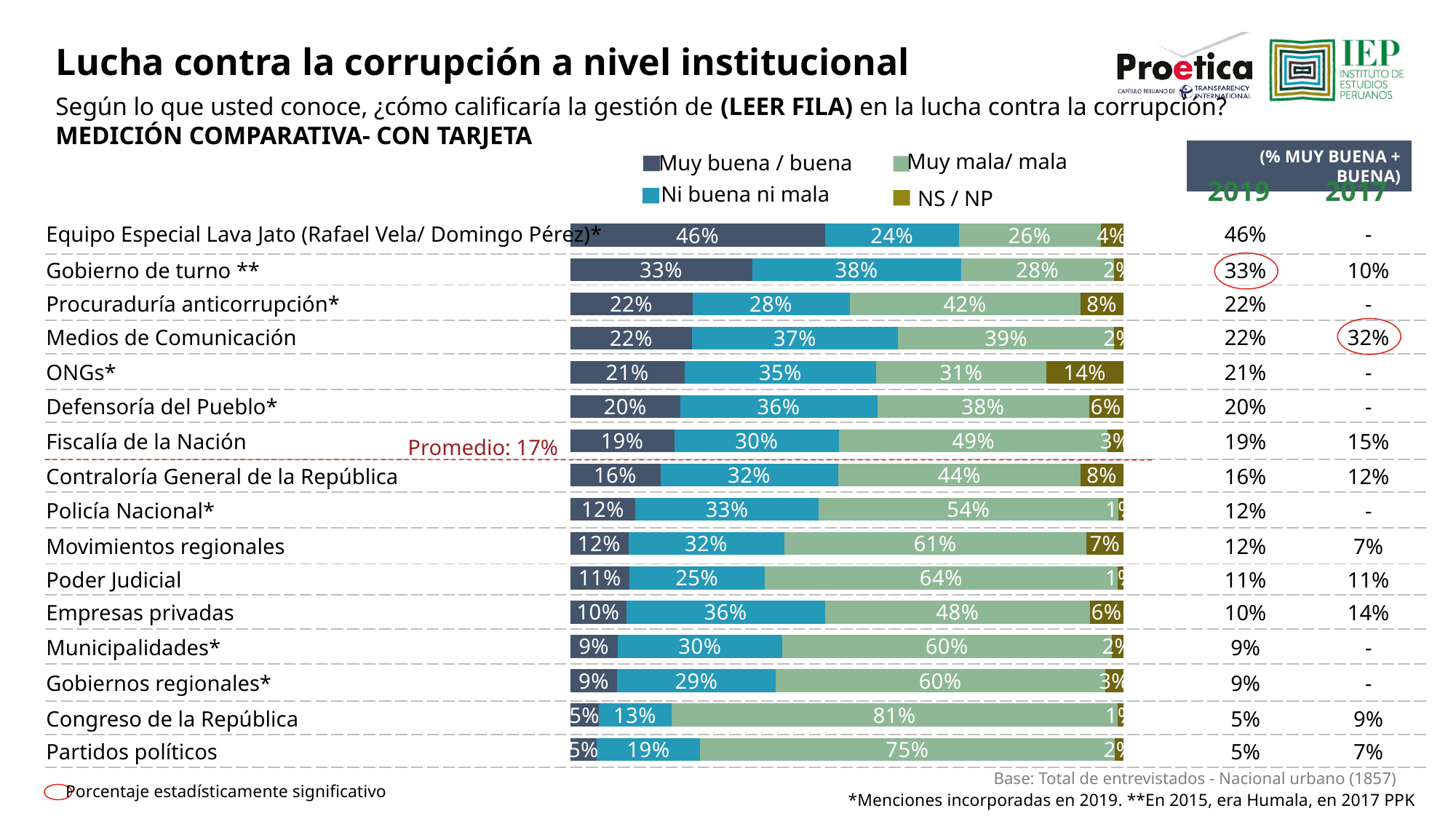
What is the difference between the 'Muy mala/ mala' values for Poder Judicial and Partidos políticos? 11% Which institution has the highest 'Muy buena / buena' value? Equipo Especial Lava Jato (Rafael Vela/ Domingo Pérez) What is the 'NS / NP' value for ONGs? 14% What average ('Promedio') is annotated on the chart? 17% What is the 'Muy mala/ mala' value for Congreso de la República? 81% How many series does the legend list? 4 Which is larger: the 'Ni buena ni mala' value for Gobierno de turno or for Medios de Comunicación? Gobierno de turno How many institutions (categories) are plotted in the chart? 16 What is the 'Muy buena / buena' value for Medios de Comunicación in 2017, according to the table on the right? 32% Which institution has the highest 'Muy mala/ mala' value? Congreso de la República What kind of chart is shown on the slide? Stacked bar chart What is the 'Muy buena / buena' value for Equipo Especial Lava Jato (Rafael Vela/ Domingo Pérez)? 46%